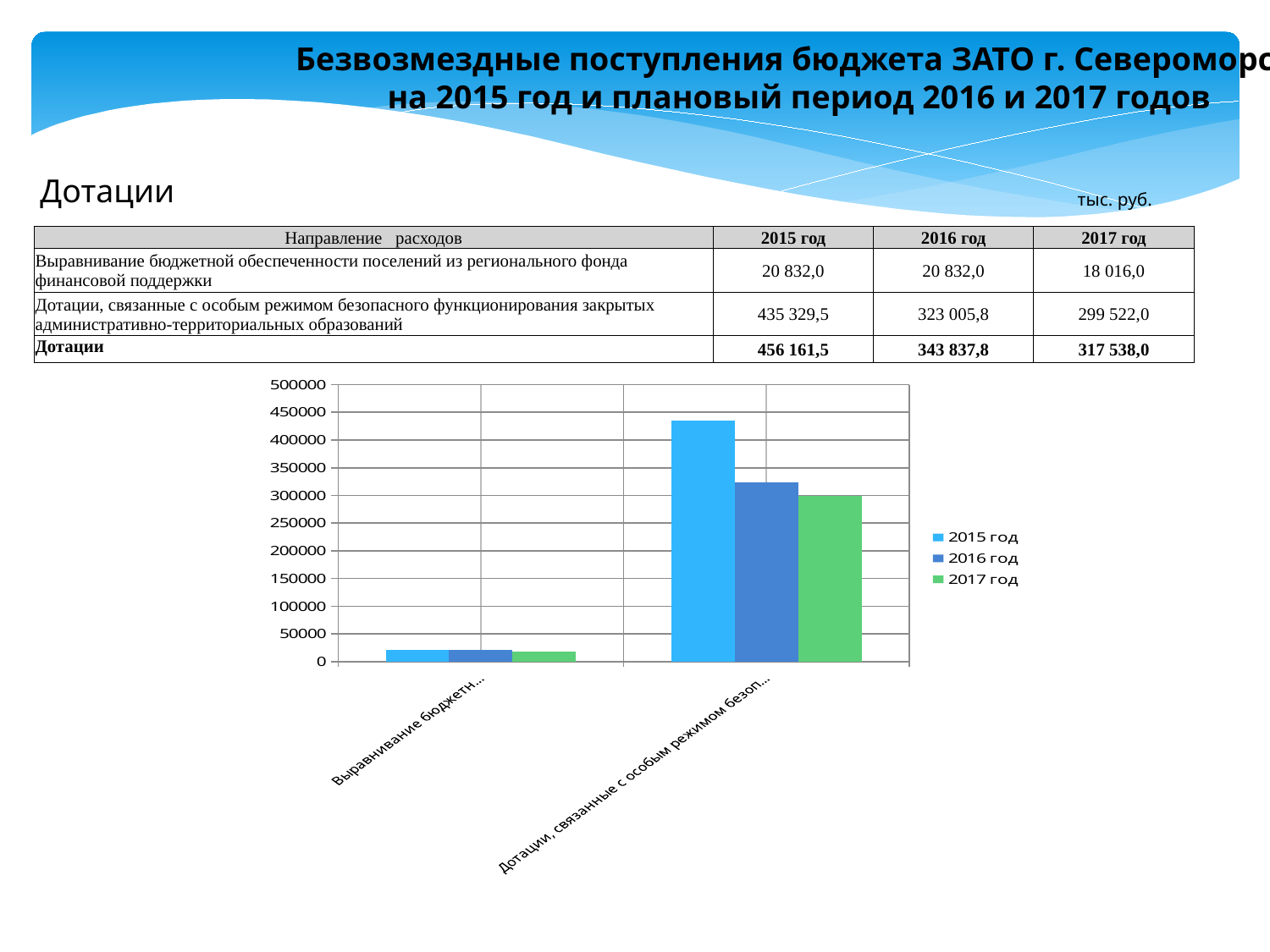
How many categories are plotted on the x axis of the chart? 2 According to the table, what is the 2015 год value for «Дотации, связанные с особым режимом безопасного функционирования закрытых административно-территориальных образований»? 435 329,5 What kind of chart is shown on the slide? bar chart In the chart, is the 2015 год value for «Дотации, связанные с особым режимом безопасного функционирования закрытых административно-территориальных образований» greater or less than 400000? greater Which year has the tallest bar for «Дотации, связанные с особым режимом безопасного функционирования закрытых административно-территориальных образований»? 2015 год In the chart, is the 2017 год value for «Дотации, связанные с особым режимом безопасного функционирования закрытых административно-территориальных образований» greater or less than 350000? less In the chart, is the 2016 год value for «Выравнивание бюджетной обеспеченности поселений из регионального фонда финансовой поддержки» greater or less than 50000? less According to the table, what is the difference between the 2015 год and 2016 год values for «Дотации, связанные с особым режимом безопасного функционирования закрытых административно-территориальных образований»? 112 323,7 According to the table, what is the total «Дотации» for 2017 год? 317 538,0 For «Дотации, связанные с особым режимом безопасного функционирования закрытых административно-территориальных образований», do the values rise or fall from 2015 год to 2017 год? fall How many series does the chart legend list? 3 What colour represents the 2017 год series in the chart legend? green